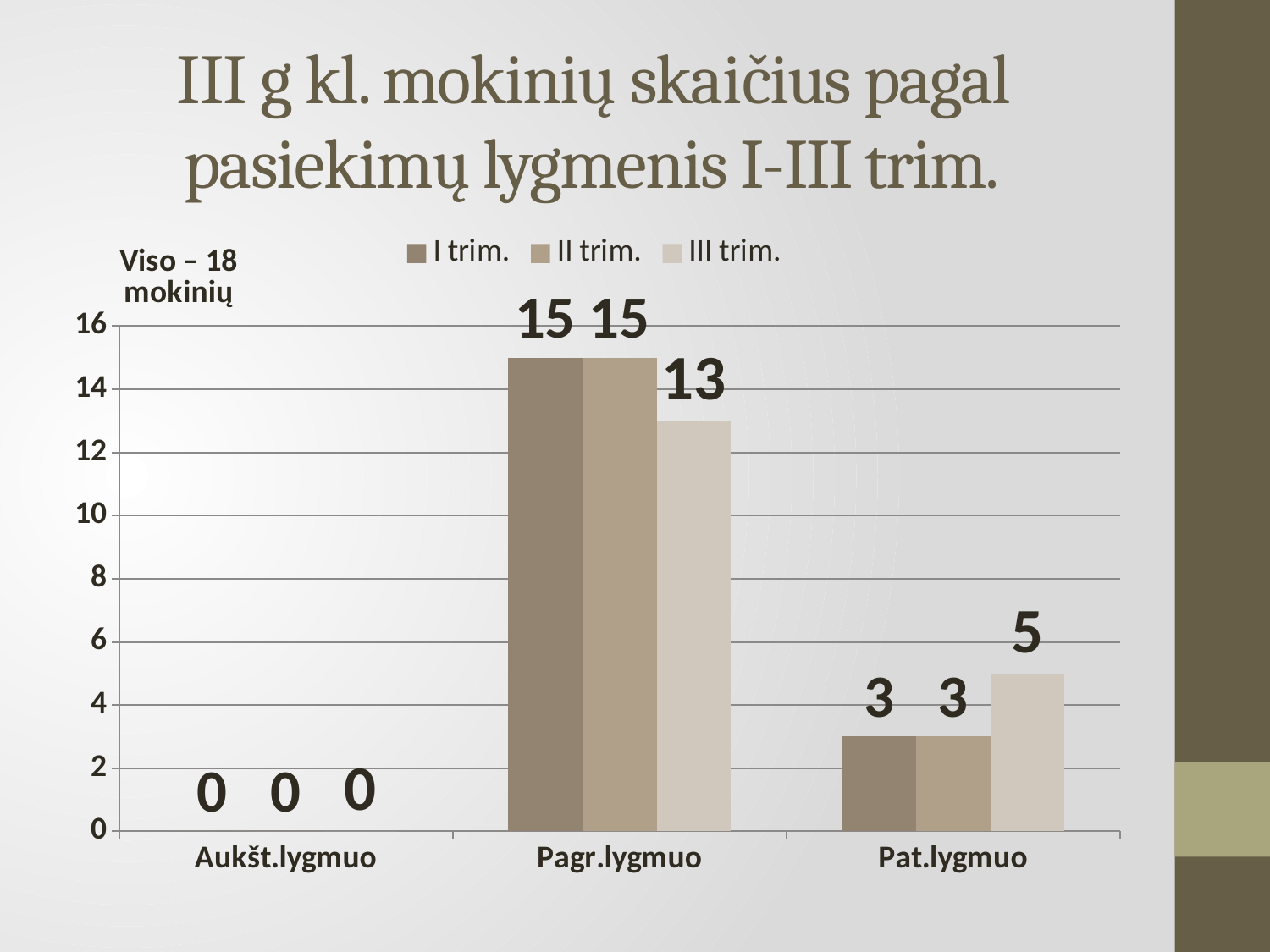
Which category has the lowest value in the I trim. series? Aukšt.lygmuo What kind of chart is shown on the slide? bar chart What is the total number of students stated in the text above the chart? 18 Which is larger for Pat.lygmuo: the II trim. value or the III trim. value? III trim. Which category has the highest value in the III trim. series? Pagr.lygmuo What is the value for Pagr.lygmuo in the I trim. series? 15 What is the value for Pagr.lygmuo in the III trim. series? 13 How many series does the legend list? 3 What is the difference between the I trim. and III trim. values for Pagr.lygmuo? 2 How many categories are shown on the x axis? 3 What is the value for Aukšt.lygmuo in the II trim. series? 0 What is the value for Pat.lygmuo in the III trim. series? 5